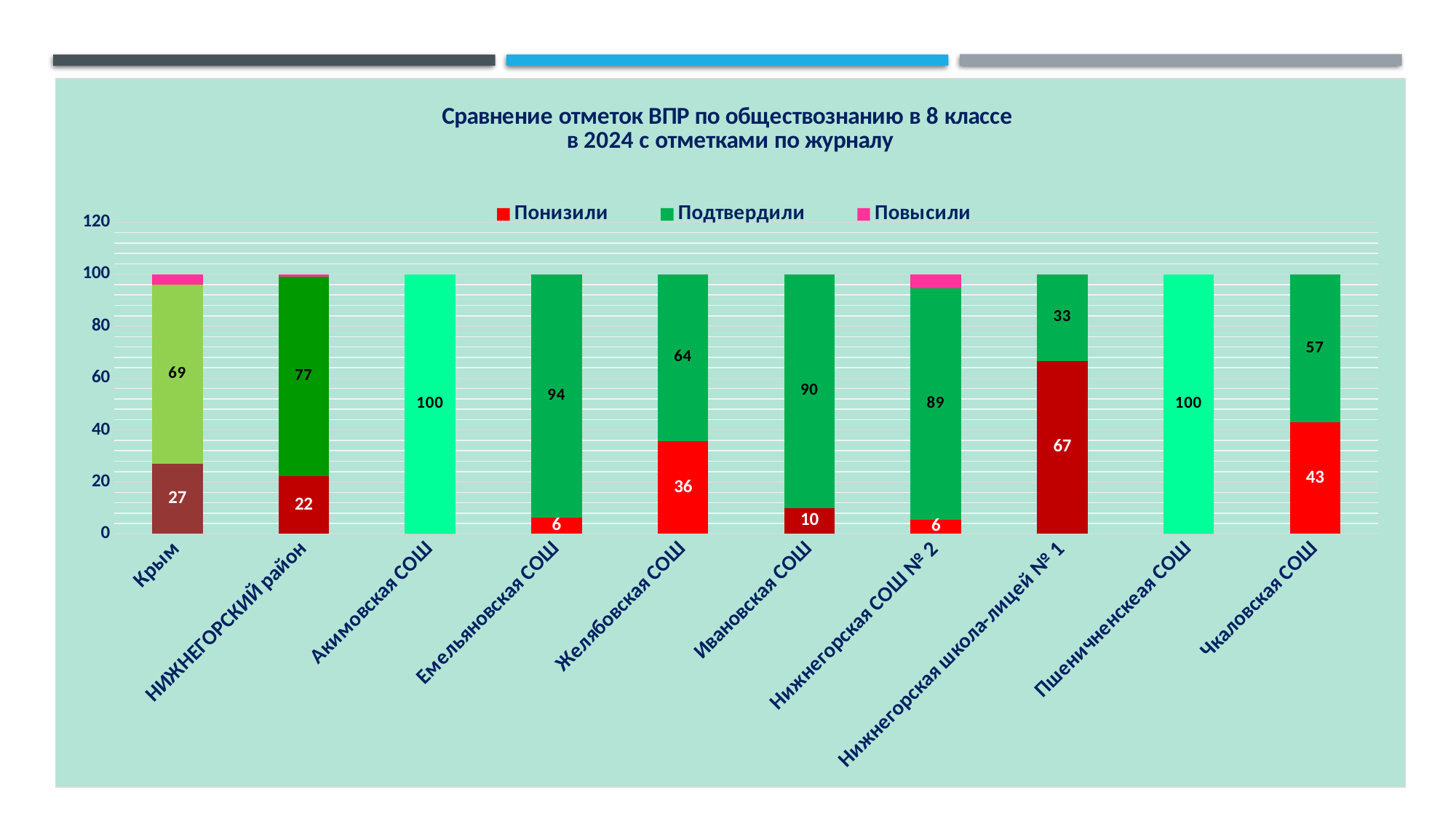
Which category has the highest Понизили value? Нижнегорская школа-лицей № 1 What is the Подтвердили value for Ивановская СОШ? 90 What is the Понизили value for Нижнегорская школа-лицей № 1? 67 How many categories are shown on the x axis? 10 What kind of chart is shown on the slide? Stacked bar chart Which category has the lowest Подтвердили value? Нижнегорская школа-лицей № 1 What is the Понизили value for Крым? 27 Which has a larger Понизили value, Чкаловская СОШ or Желябовская СОШ? Чкаловская СОШ What is the difference between the Подтвердили and Понизили values for Желябовская СОШ? 28 Which series is shown in pink in the legend? Повысили How many series does the legend list? 3 What is the total of the stacked bar for Емельяновская СОШ? 100